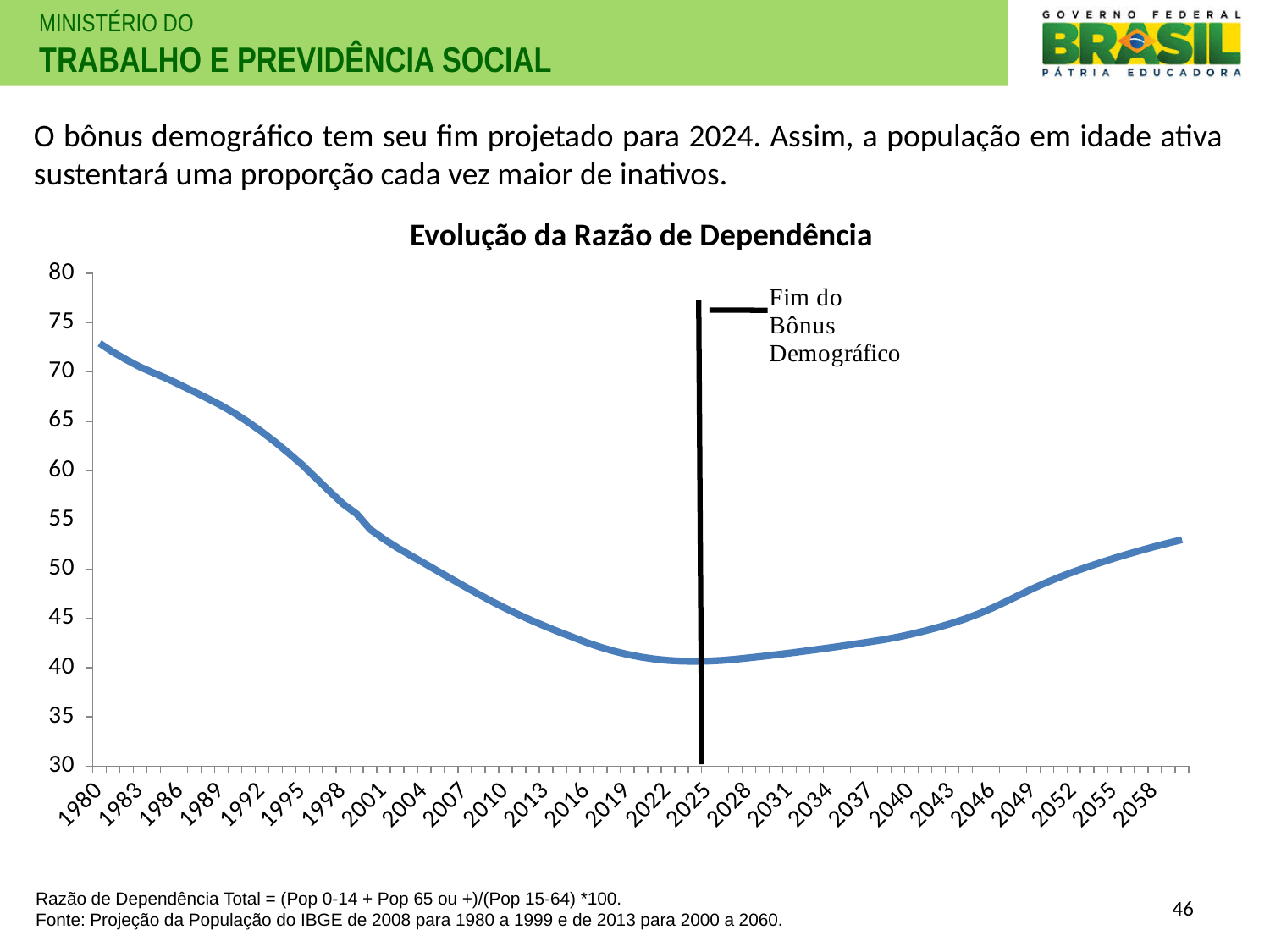
What does the label next to the vertical black line on the chart say? Fim do Bônus Demográfico Is the value for 2022 greater or less than 45? less What kind of chart is shown on the slide? line chart What is the title of the chart? Evolução da Razão de Dependência Which year has the higher value, 1980 or 2058? 1980 Does the line rise or fall between 2028 and 2058? rise Is the value for 1992 greater or less than 60? greater Is the value for 1980 greater or less than 70? greater Does the line rise or fall between 1980 and 2022? fall